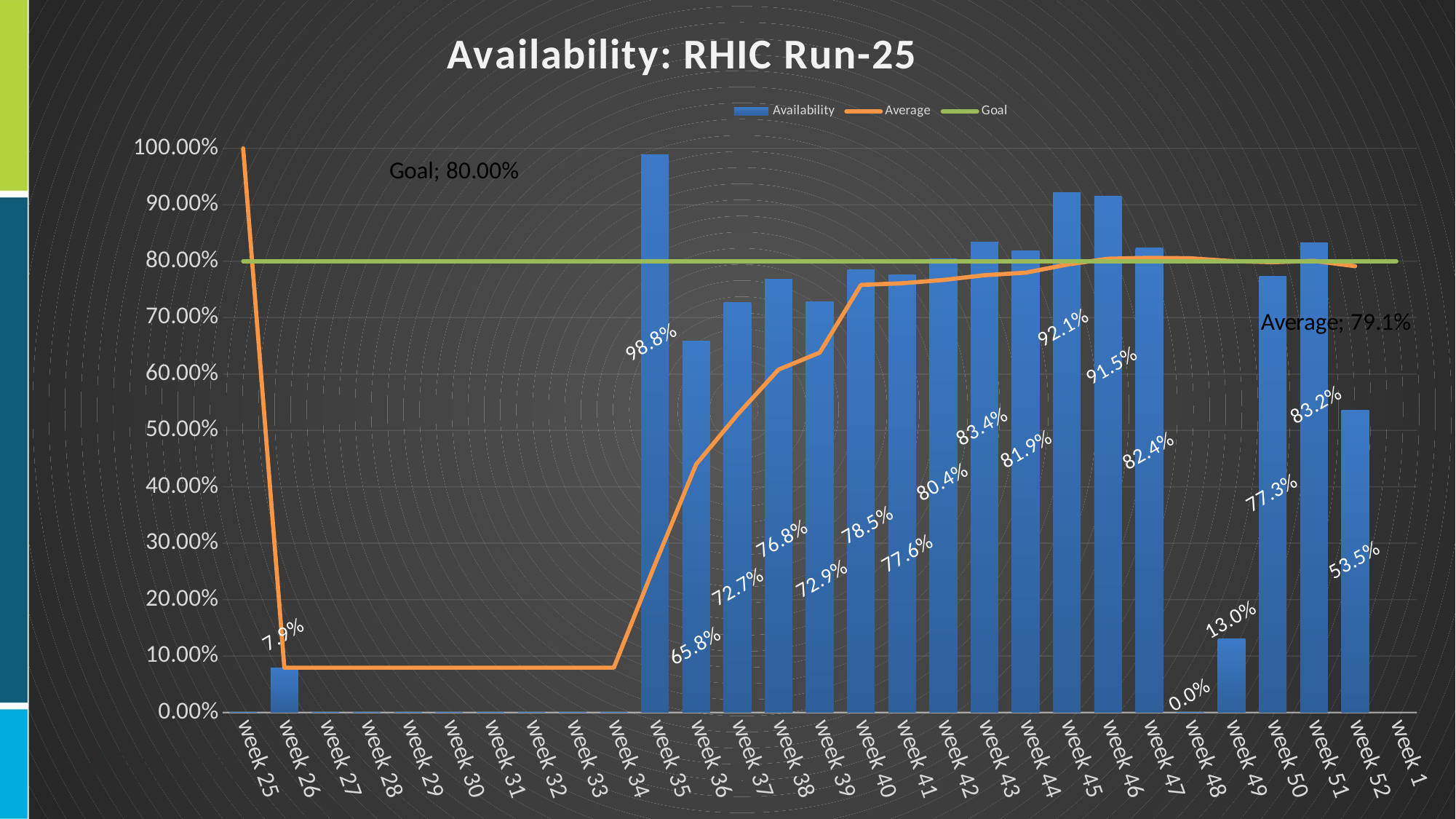
Which has the higher availability, week 43 or week 44? week 43 Does the Average line rise or fall between week 35 and week 44? rise What kind of chart is shown on the slide? bar chart (with line series) What is the title of the chart? Availability: RHIC Run-25 Which week has the highest availability? week 35 What is the Average value labeled at the end of the Average line? 79.1% What is the difference between the availability for week 35 and week 36? 33.0 percentage points What is the availability value for week 26? 7.9% What is the availability value for week 35? 98.8% What is the availability value for week 49? 13.0% What is the Goal value shown on the chart? 80.00% How many series does the legend list? 3